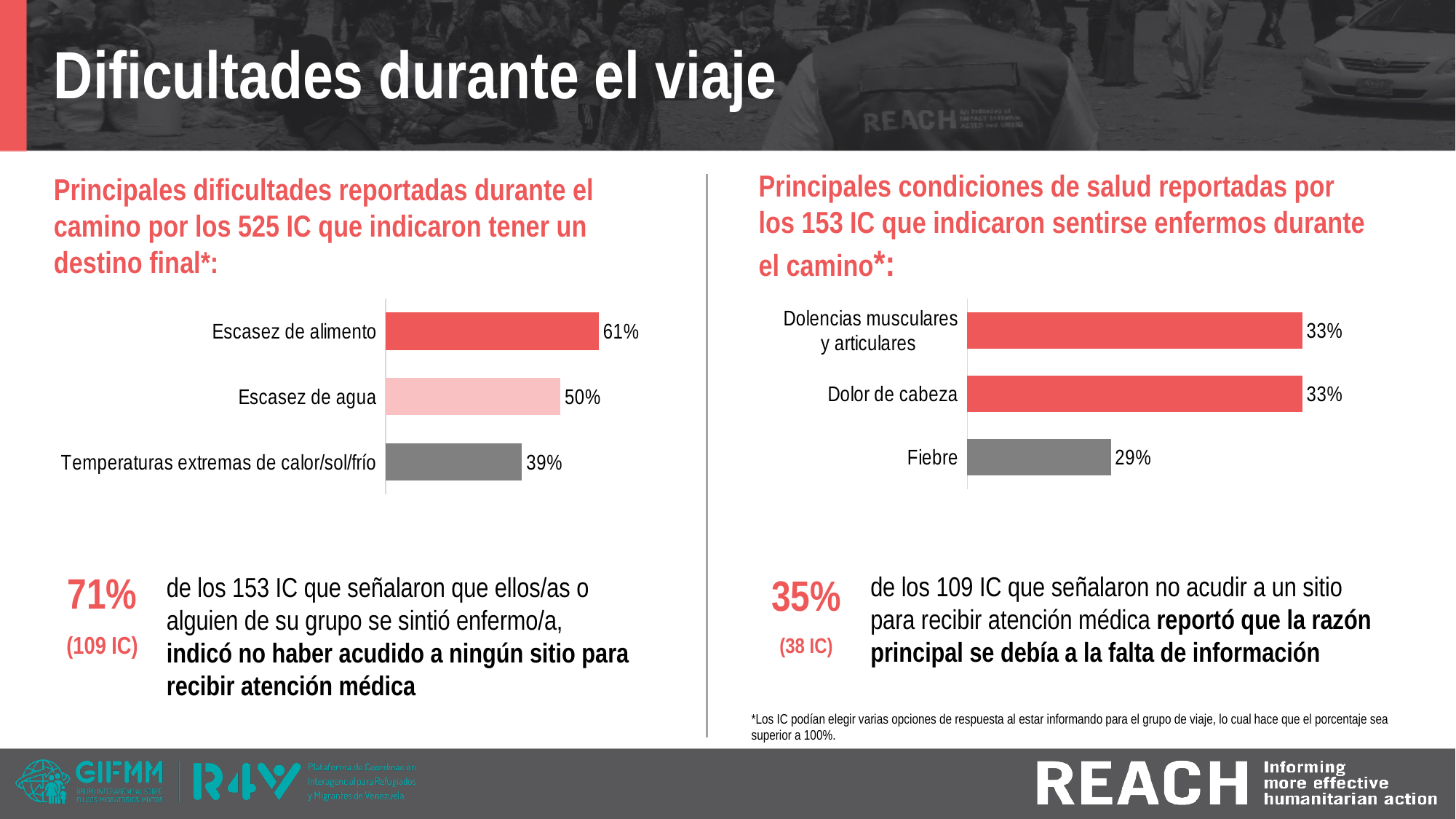
In the left chart (Principales dificultades reportadas durante el camino), what is the value for Temperaturas extremas de calor/sol/frío? 39% In the left chart (Principales dificultades reportadas durante el camino), what is the difference between Escasez de alimento and Escasez de agua? 11 percentage points In the right chart (Principales condiciones de salud reportadas), what is the value for Fiebre? 29% In the left chart (Principales dificultades reportadas durante el camino), which category has the lowest value? Temperaturas extremas de calor/sol/frío In the right chart (Principales condiciones de salud reportadas), which is larger: Dolencias musculares y articulares or Fiebre? Dolencias musculares y articulares In the left chart (Principales dificultades reportadas durante el camino), what is the value for Escasez de alimento? 61% In the right chart (Principales condiciones de salud reportadas), what is the value for Dolor de cabeza? 33% In the right chart (Principales condiciones de salud reportadas), which category has the lowest value? Fiebre In the left chart (Principales dificultades reportadas durante el camino), which category has the highest value? Escasez de alimento In the right chart (Principales condiciones de salud reportadas), what is the difference between Dolor de cabeza and Fiebre? 4 percentage points What type of chart is the left chart (Principales dificultades reportadas durante el camino)? Bar chart In the left chart (Principales dificultades reportadas durante el camino), how many categories are shown? 3